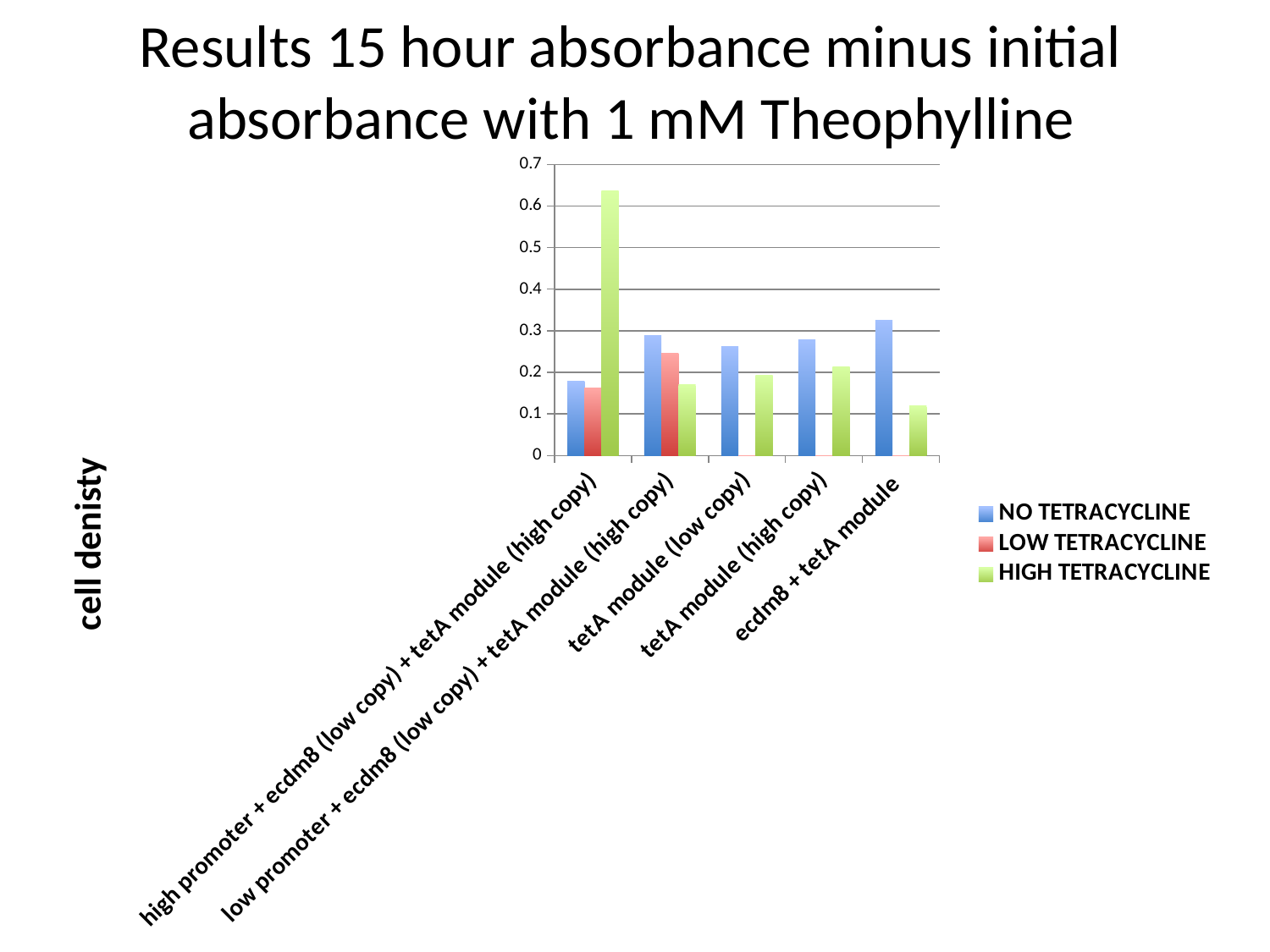
How many series does the legend list? 3 Which category has the lowest HIGH TETRACYCLINE value? ecdm8 + tetA module Is the HIGH TETRACYCLINE value for high promoter + ecdm8 (low copy) + tetA module (high copy) greater or less than 0.6? greater Is the HIGH TETRACYCLINE value for ecdm8 + tetA module greater or less than 0.2? less For low promoter + ecdm8 (low copy) + tetA module (high copy), which is larger: NO TETRACYCLINE or HIGH TETRACYCLINE? NO TETRACYCLINE How many categories are shown on the x axis of the chart? 5 Which category has the highest HIGH TETRACYCLINE value? high promoter + ecdm8 (low copy) + tetA module (high copy) What kind of chart is shown on the slide? bar chart Which category has the highest NO TETRACYCLINE value? ecdm8 + tetA module Is the NO TETRACYCLINE value for ecdm8 + tetA module greater or less than 0.3? greater Which series is shown in green in the legend? HIGH TETRACYCLINE For high promoter + ecdm8 (low copy) + tetA module (high copy), which is larger: HIGH TETRACYCLINE or NO TETRACYCLINE? HIGH TETRACYCLINE